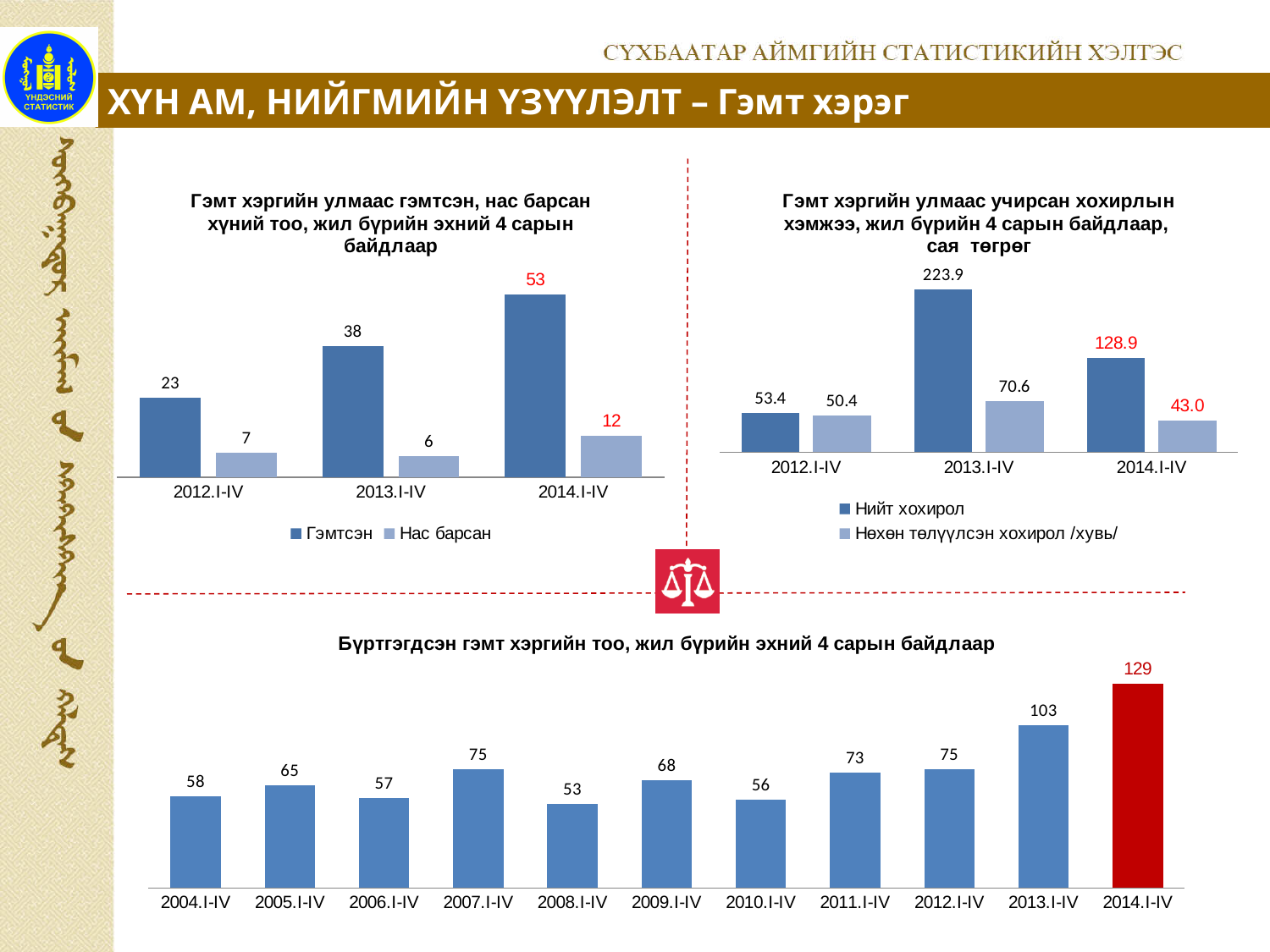
In the top-right chart (Гэмт хэргийн улмаас учирсан хохирлын хэмжээ), what is the Нөхөн төлүүлсэн хохирол /хувь/ value for 2014.I-IV? 43.0 What kind of chart is the bottom chart (Бүртгэгдсэн гэмт хэргийн тоо)? bar chart In the top-left chart (Гэмт хэргийн улмаас гэмтсэн, нас барсан хүний тоо), how many series does the legend list? 2 In the top-left chart (Гэмт хэргийн улмаас гэмтсэн, нас барсан хүний тоо), does the Гэмтсэн series rise or fall from 2012.I-IV to 2014.I-IV? rise In the bottom chart (Бүртгэгдсэн гэмт хэргийн тоо), which is larger, the value for 2005.I-IV or 2006.I-IV? 2005.I-IV In the bottom chart (Бүртгэгдсэн гэмт хэргийн тоо), which period has the lowest value? 2008.I-IV In the top-left chart (Гэмт хэргийн улмаас гэмтсэн, нас барсан хүний тоо), what is the Гэмтсэн value for 2013.I-IV? 38 In the bottom chart (Бүртгэгдсэн гэмт хэргийн тоо), how many periods are shown on the x axis? 11 In the bottom chart (Бүртгэгдсэн гэмт хэргийн тоо), what is the difference between the values for 2014.I-IV and 2013.I-IV? 26 In the bottom chart (Бүртгэгдсэн гэмт хэргийн тоо), what is the value for 2014.I-IV? 129 In the top-right chart (Гэмт хэргийн улмаас учирсан хохирлын хэмжээ), which period has the highest Нийт хохирол value? 2013.I-IV In the top-right chart (Гэмт хэргийн улмаас учирсан хохирлын хэмжээ), what is the Нийт хохирол value for 2013.I-IV? 223.9